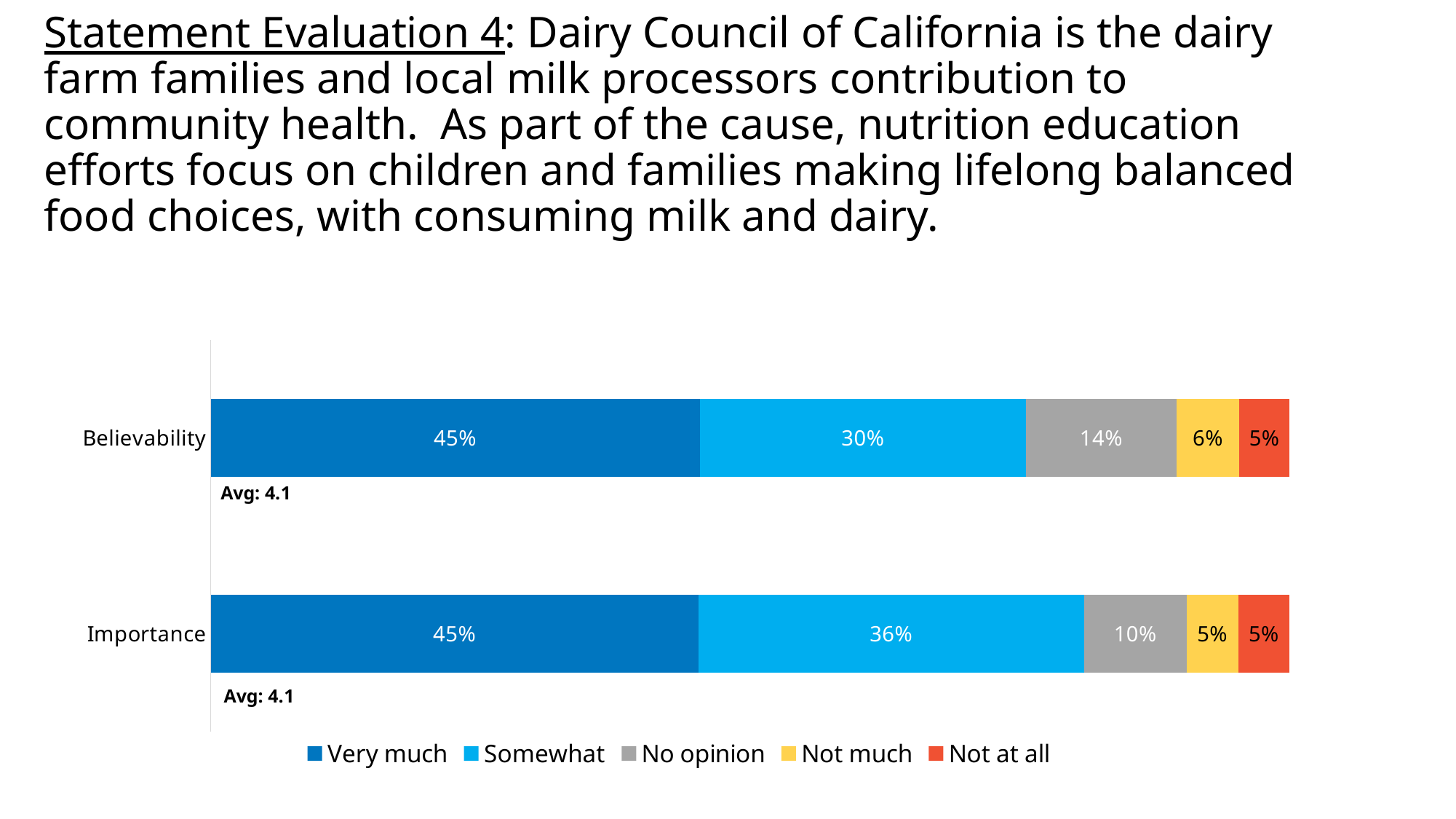
What is the difference between the "Somewhat" values for Importance and Believability? 6% Which response category has the smallest share for Believability? Not at all Is the "No opinion" share larger for Believability or for Importance? Believability How many series does the legend list? 5 What is the average score shown for Believability? 4.1 What is the "No opinion" value for Believability? 14% What is the "Not much" value for Importance? 5% How many categories are shown on the vertical axis of the chart? 2 What percentage of respondents answered "Very much" for Believability? 45% What percentage of respondents answered "Somewhat" for Importance? 36% Which response category has the largest share for Importance? Very much What type of chart is shown on the slide? Stacked bar chart